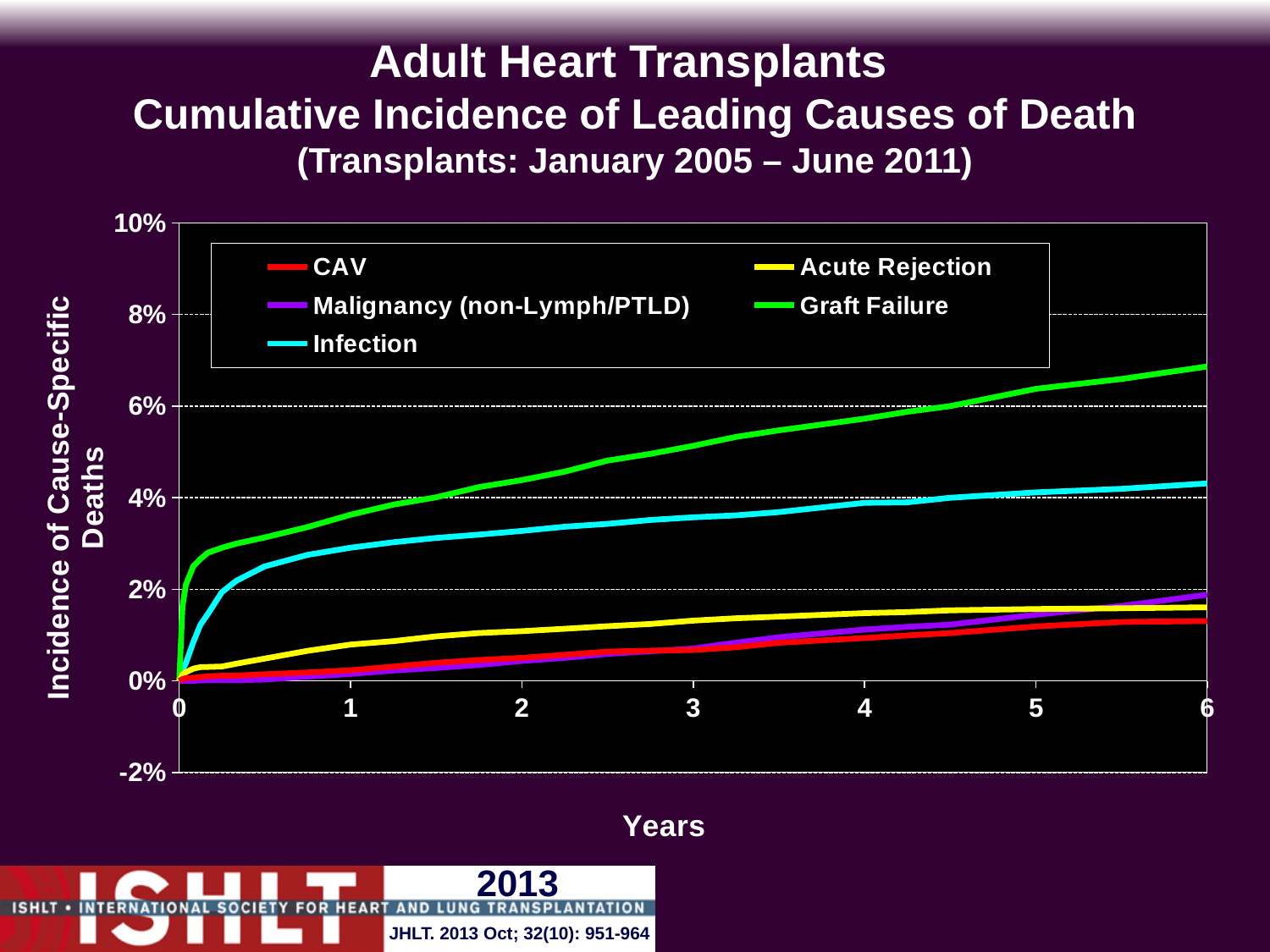
Is the value for Infection at 6 years greater or less than 4%? greater Is the value for Graft Failure at 6 years greater or less than 6%? greater What colour is the Graft Failure line in the legend? Green Which cause of death has the highest cumulative incidence at 6 years? Graft Failure Does the cumulative incidence for Graft Failure rise or fall as years increase? Rise What kind of chart is shown on the slide? Line chart Is the value for Graft Failure at 1 year greater or less than 2%? greater How many series does the legend list? 5 At 2 years, which is larger: the value for Infection or the value for Acute Rejection? Infection At 6 years, which is larger: the value for Graft Failure or the value for Infection? Graft Failure